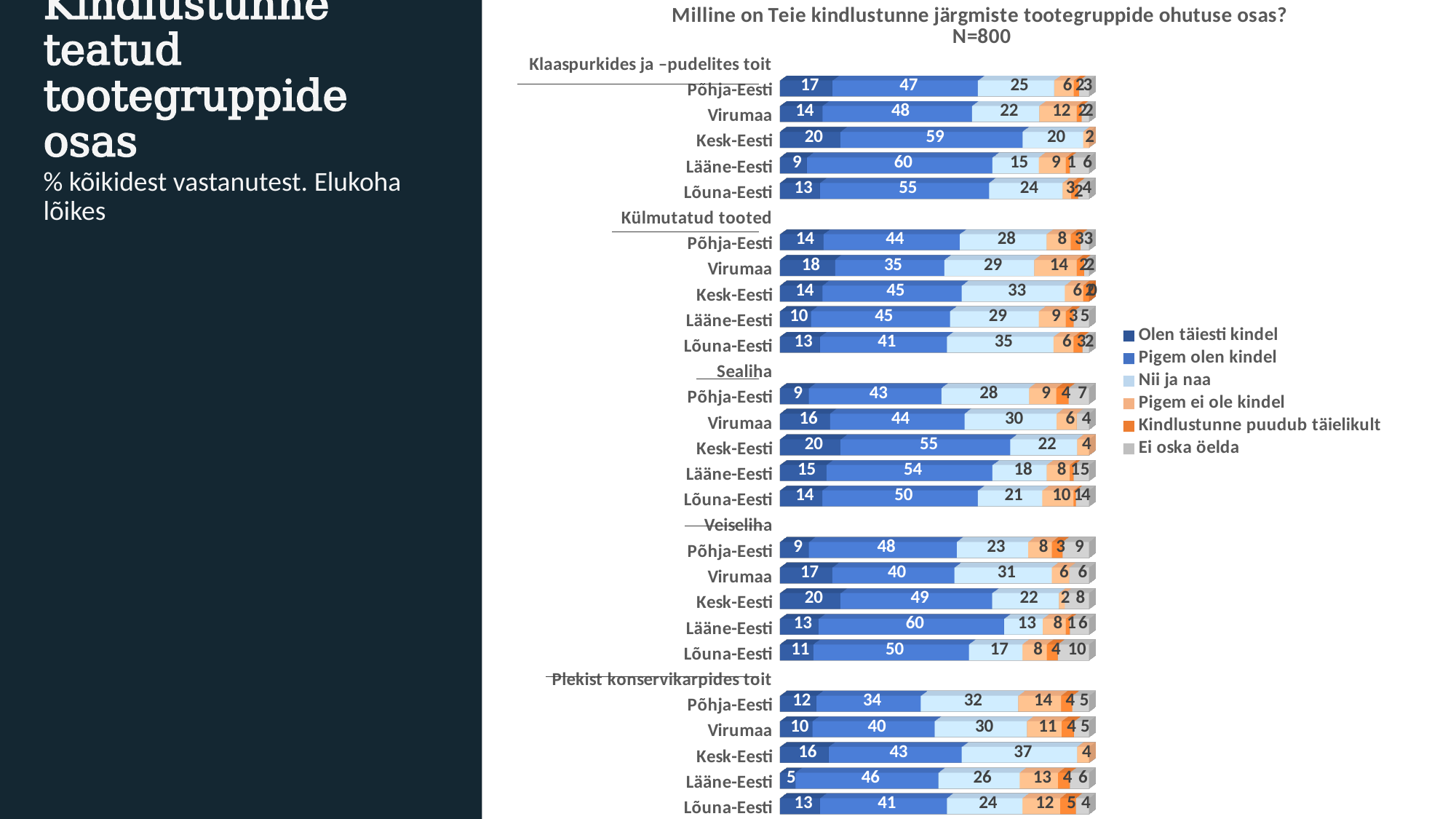
What is the sample size (N) stated in the chart title? N=800 In the Klaaspurkides ja -pudelites toit group, what is the difference between the 'Pigem olen kindel' values for Kesk-Eesti and Virumaa? 11 How many product groups are shown in the chart? 5 In the Plekist konservikarpides toit group, which has the larger 'Nii ja naa' value: Kesk-Eesti or Põhja-Eesti? Kesk-Eesti In the Plekist konservikarpides toit group, which region has the lowest 'Olen täiesti kindel' value? Lääne-Eesti What kind of chart is shown on the slide? Stacked bar chart In the Plekist konservikarpides toit group, what is the 'Pigem ei ole kindel' value for Põhja-Eesti? 14 In the Klaaspurkides ja -pudelites toit group, what is the 'Pigem olen kindel' value for Kesk-Eesti? 59 How many series does the legend list? 6 In the Sealiha group, what is the 'Olen täiesti kindel' value for Kesk-Eesti? 20 In the Veiseliha group, which region has the highest 'Pigem olen kindel' value? Lääne-Eesti In the Külmutatud tooted group, what is the 'Nii ja naa' value for Lõuna-Eesti? 35